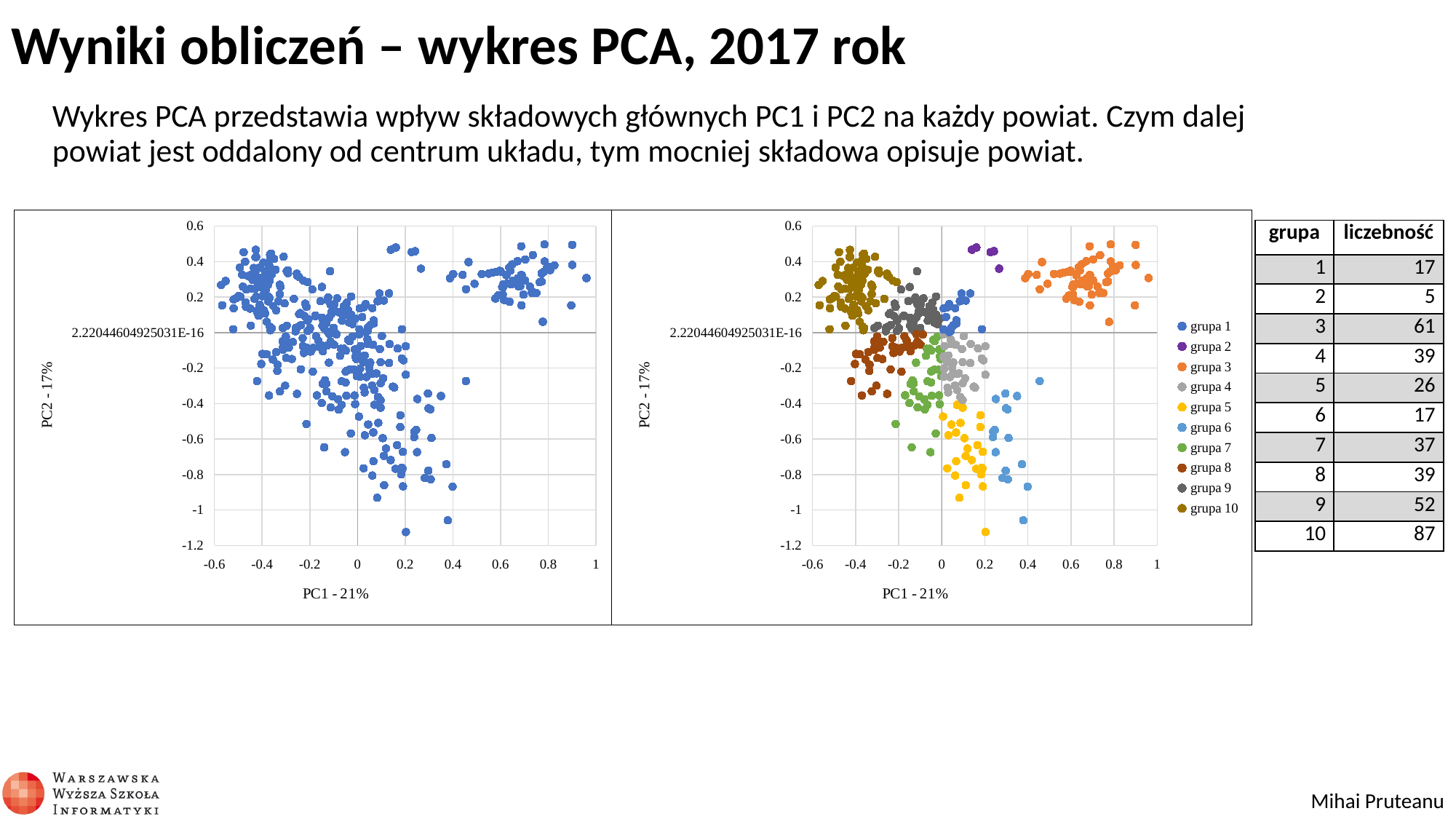
On the right chart, which group's points lie further to the right along PC1, grupa 3 or grupa 10? grupa 3 On the right chart, which group's points lie higher along PC2, grupa 2 or grupa 5? grupa 2 On the right chart, are the PC1 values of the grupa 10 points greater or less than 0? less On the right chart, are the PC2 values of the grupa 2 points greater or less than 0.2? greater What kind of chart is the left chart on the slide? scatter chart On the right chart, are the PC2 values of the grupa 3 points greater or less than 0? greater How many series does the legend of the right chart list? 10 On the right chart, which group is plotted in orange? grupa 3 What is the x-axis label of the right chart? PC1 - 21%